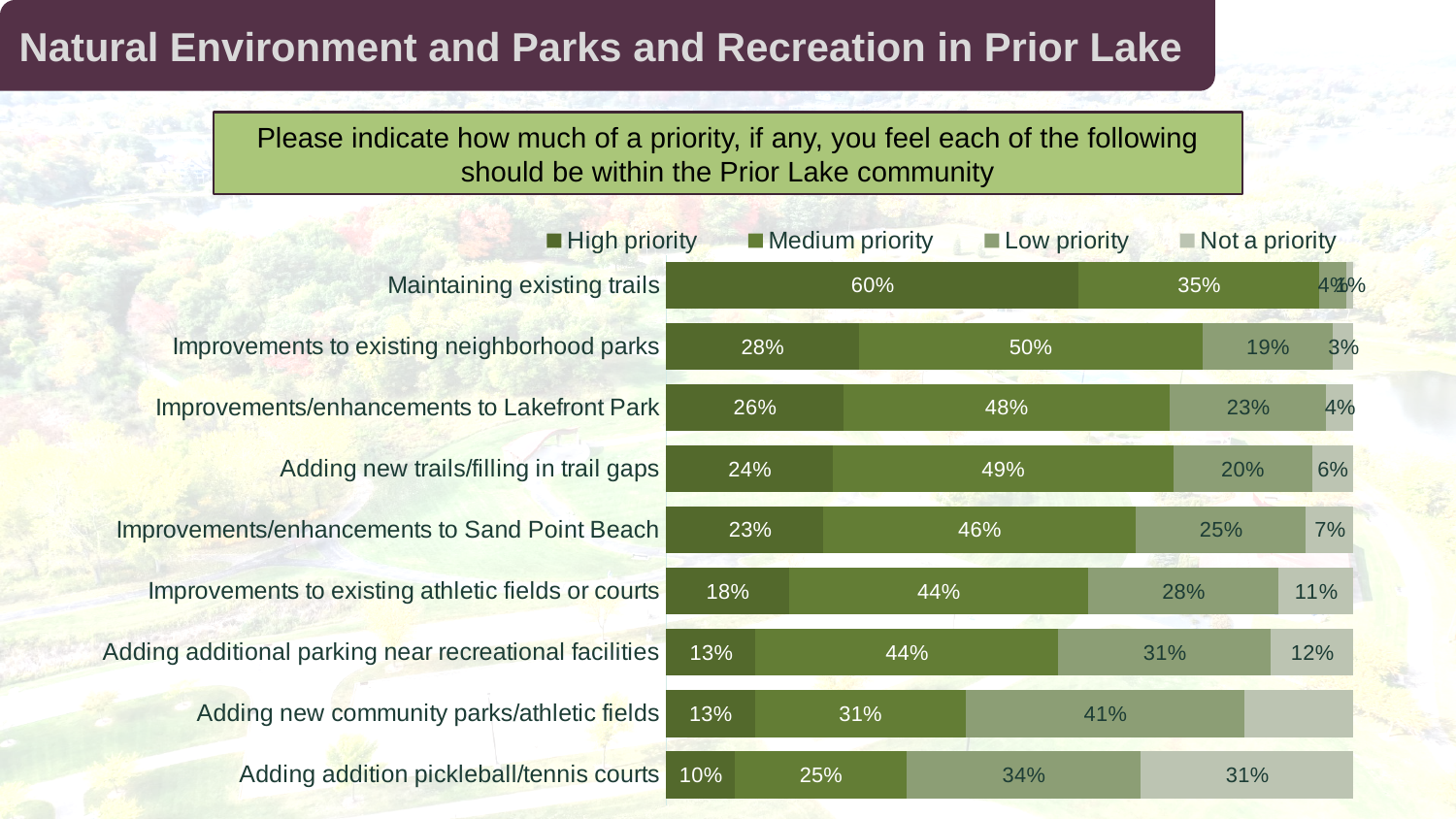
What is the 'Low priority' value for 'Improvements/enhancements to Sand Point Beach'? 25% Which item has the lowest 'High priority' percentage? Adding addition pickleball/tennis courts What is the difference between the 'High priority' values for 'Maintaining existing trails' and 'Improvements/enhancements to Lakefront Park'? 34% What is the total of the four segments for 'Adding addition pickleball/tennis courts'? 100% What is the 'Not a priority' value for 'Adding addition pickleball/tennis courts'? 31% Which has a larger 'Low priority' value: 'Adding additional parking near recreational facilities' or 'Improvements to existing athletic fields or courts'? Adding additional parking near recreational facilities What is the 'Medium priority' value for 'Adding new trails/filling in trail gaps'? 49% How many series does the legend list? 4 What kind of chart is shown on the slide? Stacked bar chart How many items are listed in the chart? 9 Which item has the highest 'High priority' percentage? Maintaining existing trails What percentage of respondents rated 'Improvements to existing neighborhood parks' as a high priority? 28%